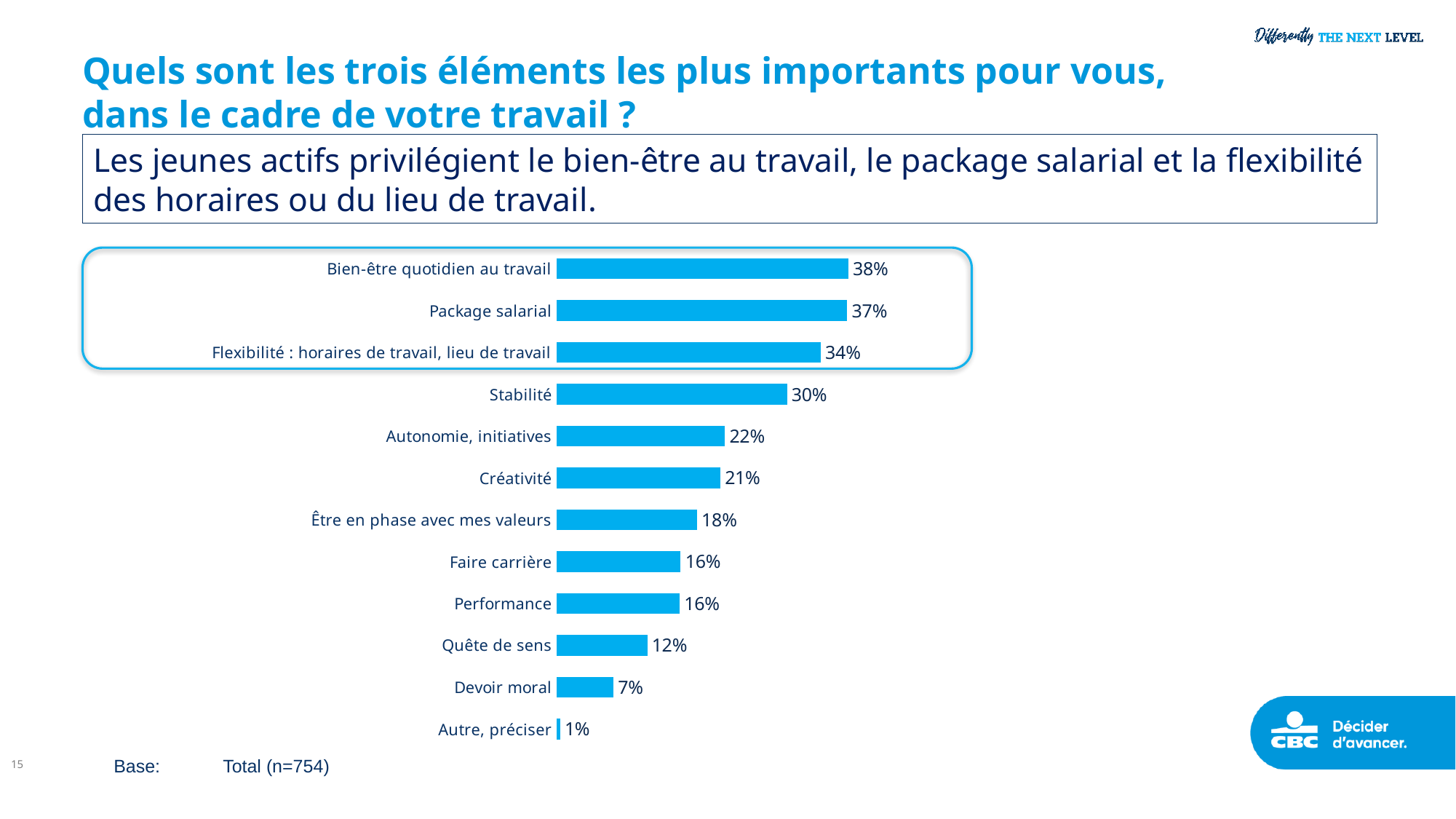
What is the difference between Autonomie, initiatives and Devoir moral? 15% What kind of chart is shown on the slide? Bar chart How many categories are shown in the chart? 12 Which category has the highest value? Bien-être quotidien au travail What is the base (sample size) stated below the chart? Total (n=754) What is the value for Quête de sens? 12% Which is larger, Stabilité or Faire carrière? Stabilité Which is larger, Créativité or Être en phase avec mes valeurs? Créativité What is the value for Stabilité? 30% What is the difference between Package salarial and Flexibilité : horaires de travail, lieu de travail? 3% What is the value for Bien-être quotidien au travail? 38% Which category has the lowest value? Autre, préciser